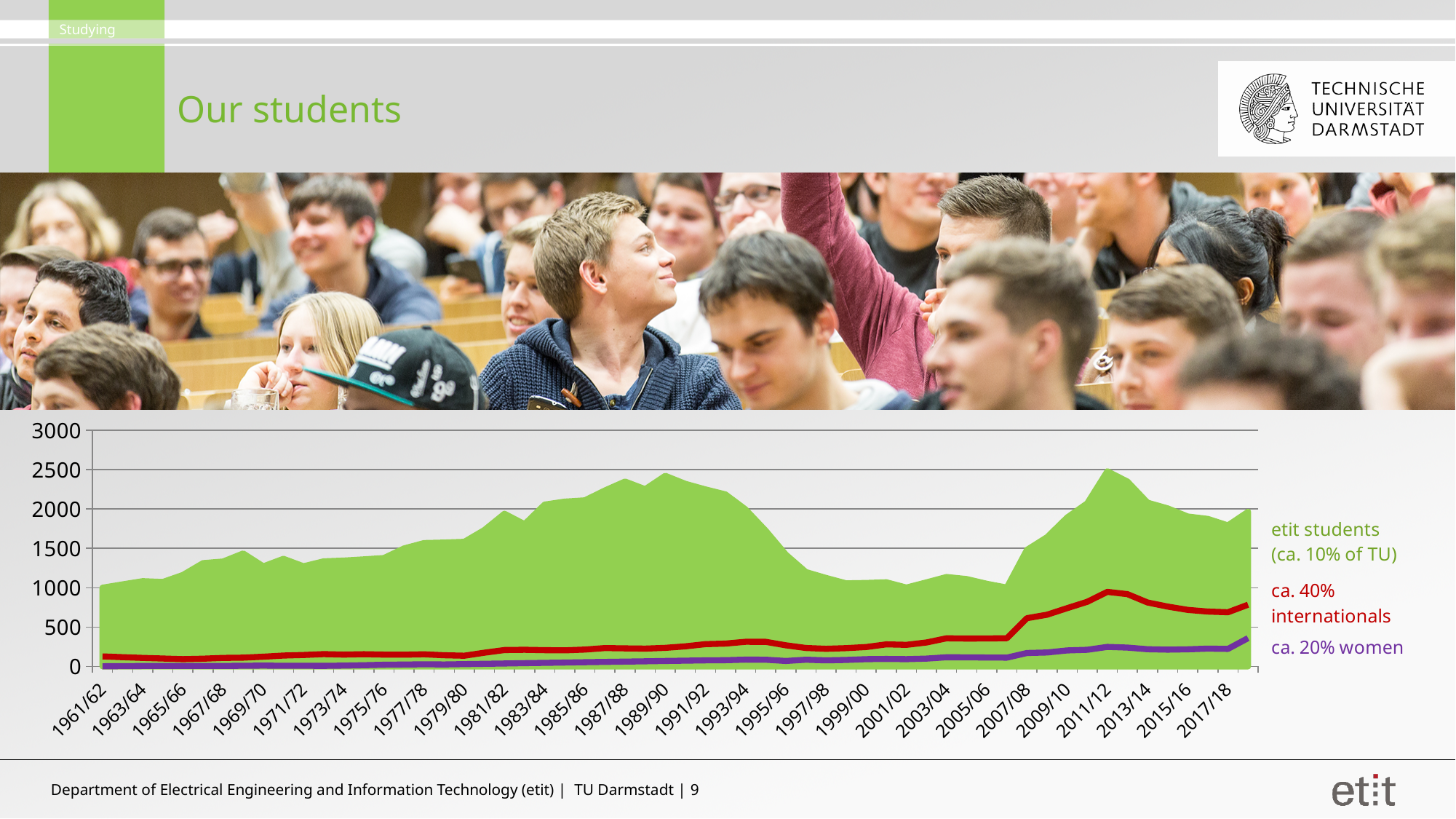
Do the etit student numbers rise or fall between 1989/90 and 1997/98? fall Is the value for etit students in 1997/98 greater or less than 1500? less What colour is the area representing etit students? green Which is larger, the number of etit students in 1989/90 or in 2001/02? 1989/90 What kind of chart is shown on the slide? combination area and line chart Is the value for women in 2017/18 greater or less than 500? less Is the value for etit students in 1961/62 greater or less than 500? greater In 2011/12, which series has the larger value, internationals or women? internationals How many series are labelled on the chart? 3